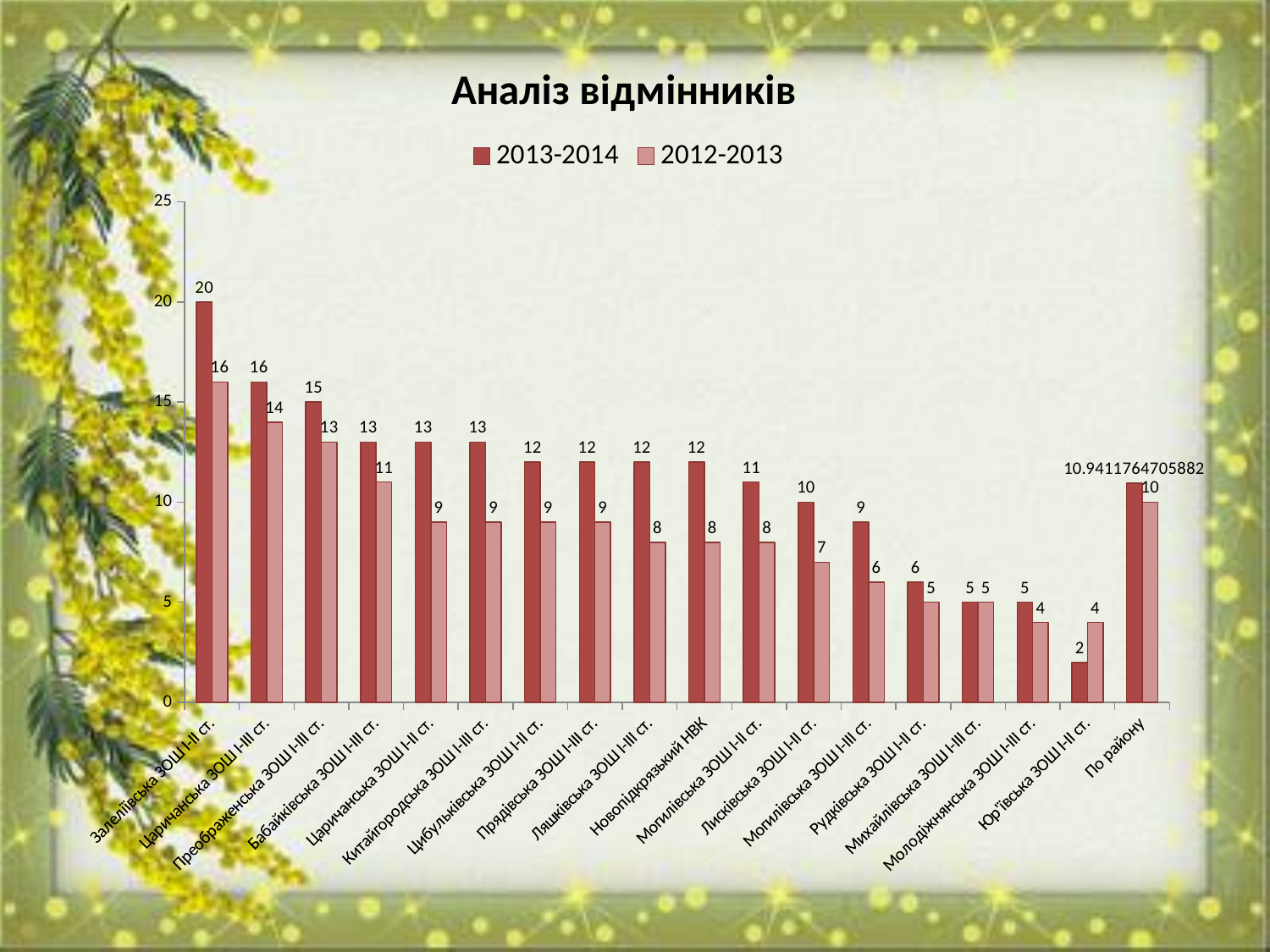
What is the difference between the 2013-2014 and 2012-2013 values for Царичанська ЗОШ І-ІІ ст.? 4 For Юр'ївська ЗОШ І-ІІ ст., which series has the larger value, 2013-2014 or 2012-2013? 2012-2013 Which category has the lowest value in the 2013-2014 series? Юр'ївська ЗОШ І-ІІ ст. What is the value for Лисківська ЗОШ І-ІІ ст. in the 2012-2013 series? 7 What is the value for Залелівська ЗОШ І-ІІ ст. in the 2013-2014 series? 20 Which category has the highest value in the 2013-2014 series? Залелівська ЗОШ І-ІІ ст. How many categories are shown on the x axis? 18 What is the value for По району in the 2013-2014 series? 10.9411764705882 What is the title of the chart? Аналіз відмінників What kind of chart is shown on the slide? bar chart How many series does the legend list? 2 What is the value for Михайлівська ЗОШ І-ІІІ ст. in the 2012-2013 series? 5